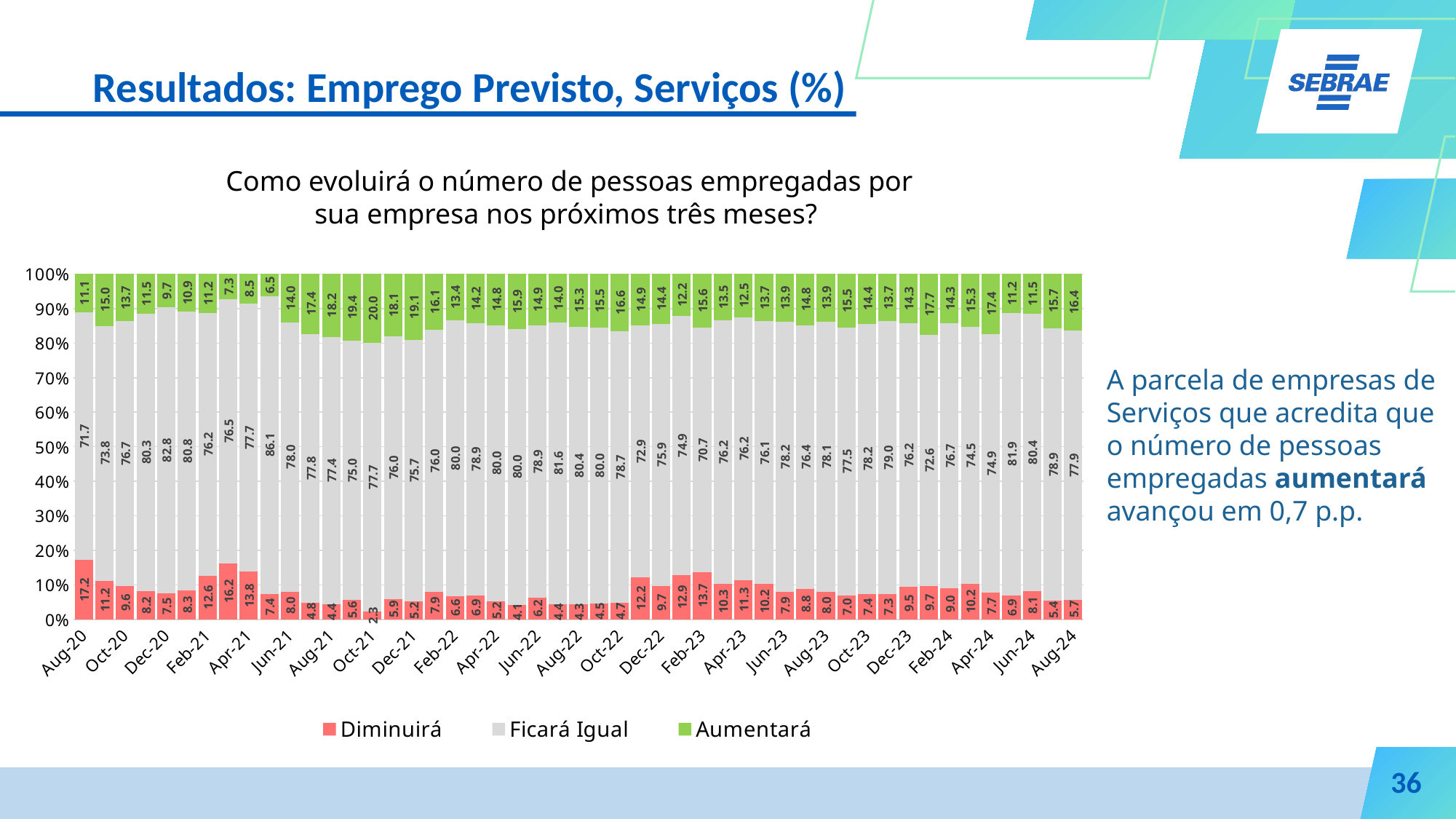
Does the Diminuirá value rise or fall from Aug-20 to Dec-20? Fall What is the difference between the Aumentará value for Aug-24 and for Aug-20? 5.3 How many series does the legend list? 3 What is the value of Ficará Igual for Feb-23? 70.7 In which month does Diminuirá reach its lowest value? Oct-21 What type of chart is shown on the slide? Stacked bar chart In which month does Aumentará reach its highest value? Oct-21 What is the value of Aumentará for Aug-24? 16.4 Which is larger, the Diminuirá value for Feb-23 or for Apr-23? Feb-23 What is the value of Ficará Igual for Dec-20? 82.8 What is the value of Diminuirá for Aug-20? 17.2 What are the three series named in the legend? Diminuirá, Ficará Igual, Aumentará